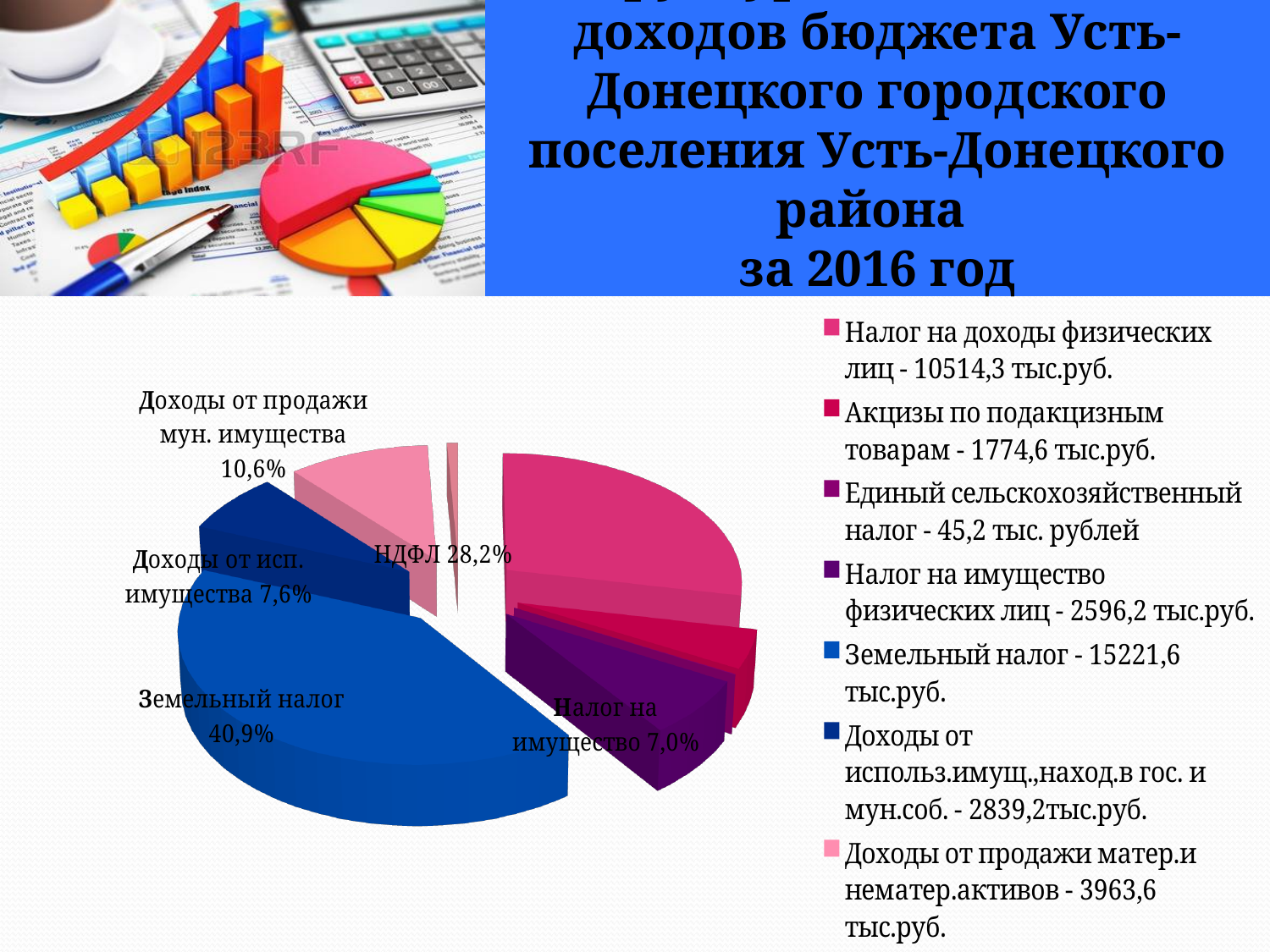
Which slice of the pie is the largest? Земельный налог What share of the pie does Доходы от продажи мун. имущества have? 10,6% What share of the pie does Земельный налог have? 40,9% According to the legend, what is the value for Земельный налог? 15221,6 тыс.руб. What kind of chart is shown on the slide? Pie chart According to the legend, what is the value for Налог на доходы физических лиц? 10514,3 тыс.руб. What share of the pie does НДФЛ have? 28,2% How many entries does the legend list? 7 By how many percentage points does the share of Земельный налог exceed the share of НДФЛ? 12,7 Which is larger, the share for Земельный налог or the share for НДФЛ? Земельный налог